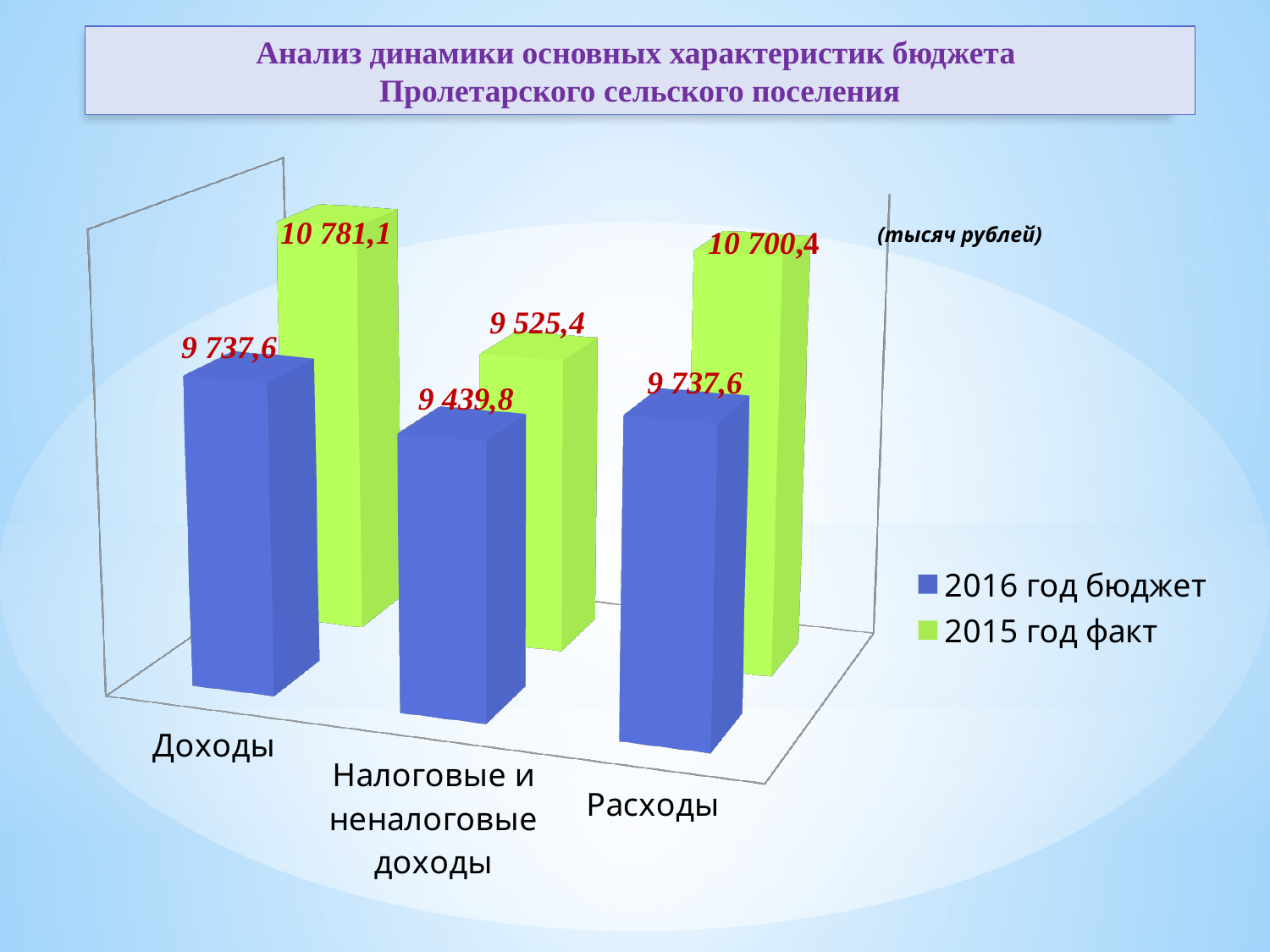
What is the difference between the 2015 год факт and 2016 год бюджет values for Расходы? 962,8 For Расходы, which series has the larger value: 2016 год бюджет or 2015 год факт? 2015 год факт Which category has the highest value in the 2015 год факт series? Доходы What is the value for Доходы in the 2015 год факт series? 10 781,1 What is the value for Налоговые и неналоговые доходы in the 2016 год бюджет series? 9 439,8 How many series does the legend list? 2 What is the value for Доходы in the 2016 год бюджет series? 9 737,6 What is the difference between the 2015 год факт and 2016 год бюджет values for Доходы? 1 043,5 What kind of chart is shown on the slide? Bar chart How many categories are shown on the x axis of the chart? 3 What is the value for Расходы in the 2015 год факт series? 10 700,4 Which category has the lowest value in the 2016 год бюджет series? Налоговые и неналоговые доходы